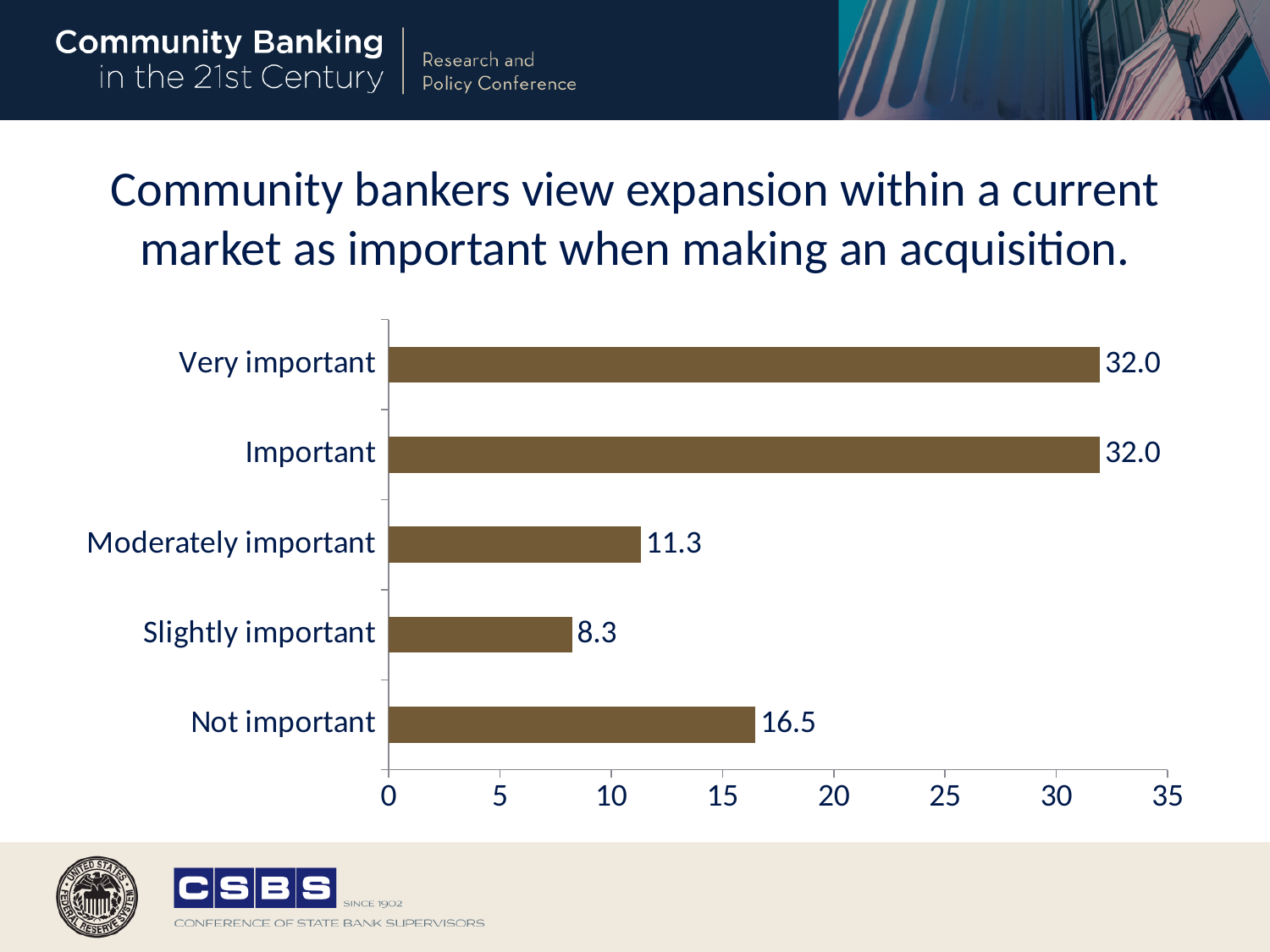
What is the difference between the values for Very important and Moderately important? 20.7 What is the value for Slightly important? 8.3 Which category has the lowest value? Slightly important What is the value for Very important? 32.0 How many categories are shown in the chart? 5 What kind of chart is shown on the slide? bar chart What is the difference between the values for Not important and Slightly important? 8.2 What is the maximum value shown on the x axis? 35 Which is larger, the value for Not important or the value for Moderately important? Not important Is the value for Important greater or less than 30? greater What is the value for Not important? 16.5 What is the value for Moderately important? 11.3